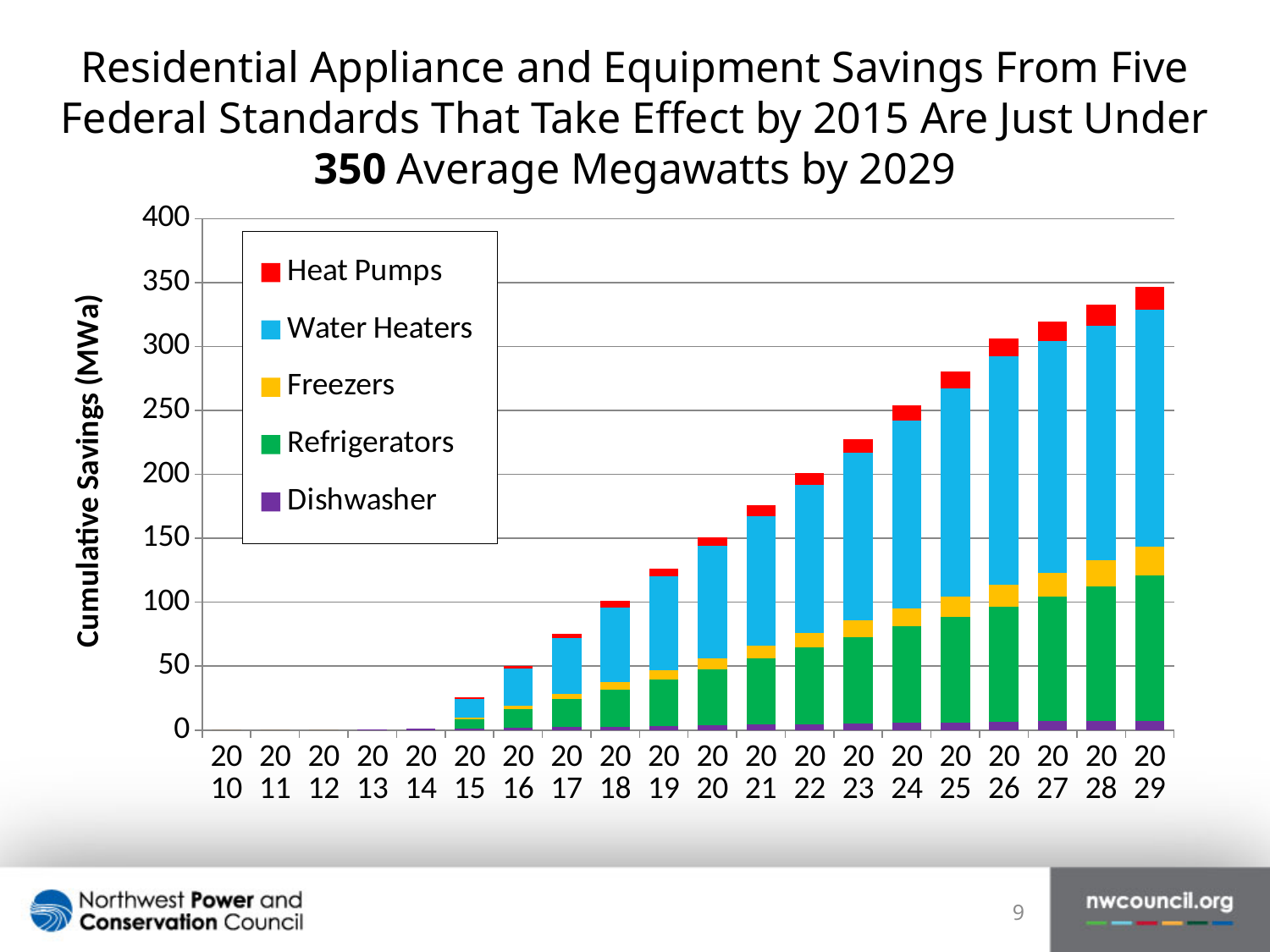
What is the title of the y axis? Cumulative Savings (MWa) How many series does the legend list? 5 Do the total cumulative savings rise or fall from 2015 to 2029? Rise Which series contributes the largest share of the 2029 bar? Water Heaters Is the total cumulative savings for 2029 greater or less than 300? greater Which year has the larger total cumulative savings, 2020 or 2029? 2029 Is the total cumulative savings for 2025 greater or less than 250? greater Which year has the highest total cumulative savings? 2029 How many years are shown along the x axis? 20 What kind of chart is shown on the slide? Stacked bar chart Is the total cumulative savings for 2015 greater or less than 50? less